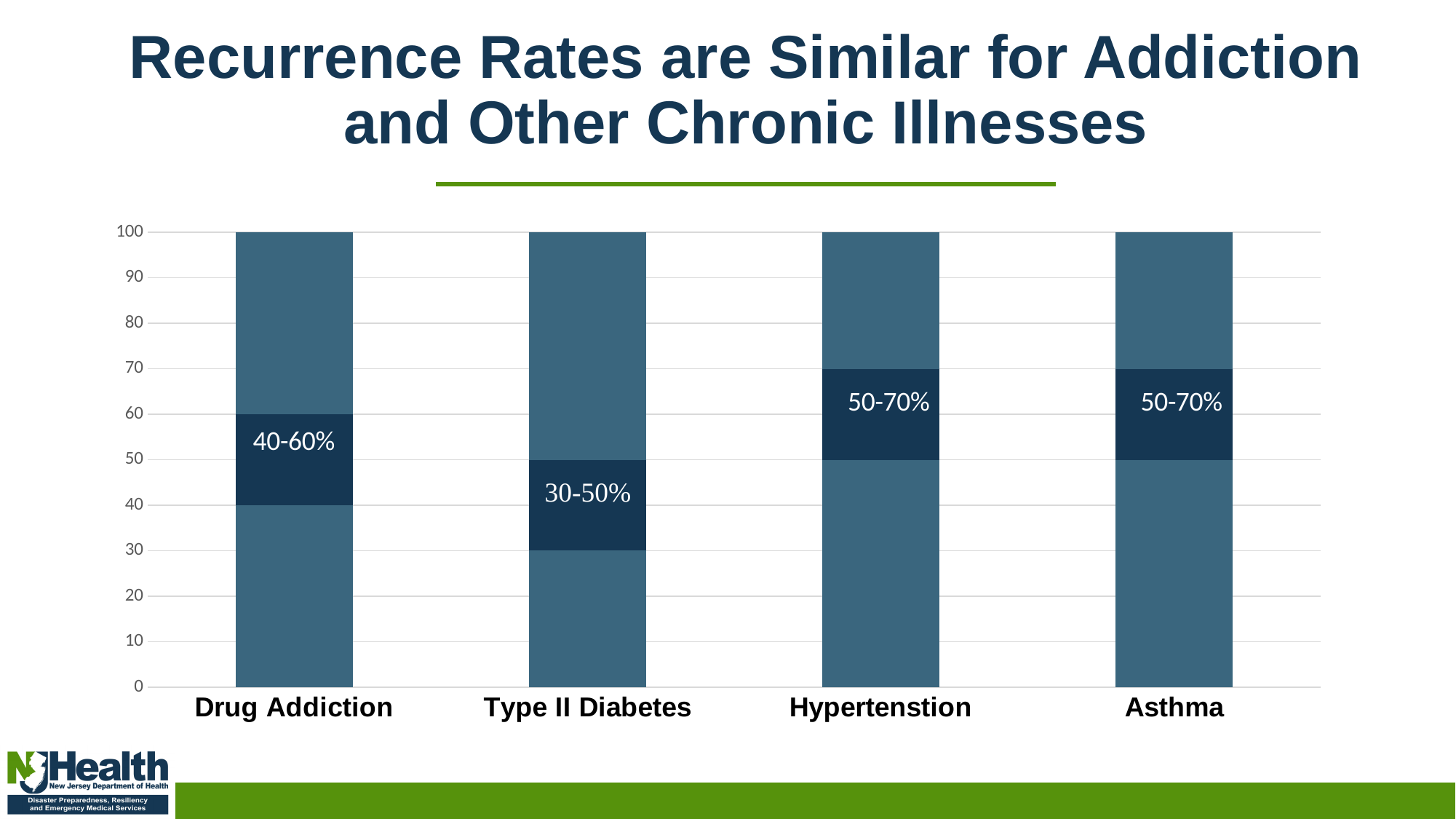
What kind of chart is shown on the slide? Stacked bar chart What recurrence rate range is labeled on the Hypertenstion bar? 50-70% What value on the y axis does the top of each full bar reach? 100 Which two categories share the highest labeled recurrence rate range of 50-70%? Hypertenstion and Asthma What is the title of the slide? Recurrence Rates are Similar for Addiction and Other Chronic Illnesses Is the lower edge of the dark segment for Hypertenstion greater or less than 40? greater Which category has the lowest labeled recurrence rate range? Type II Diabetes What recurrence rate range is labeled on the Asthma bar? 50-70% How many categories are shown on the x axis? 4 What recurrence rate range is labeled on the Drug Addiction bar? 40-60% Which has a higher labeled recurrence rate range, Drug Addiction or Type II Diabetes? Drug Addiction What recurrence rate range is labeled on the Type II Diabetes bar? 30-50%